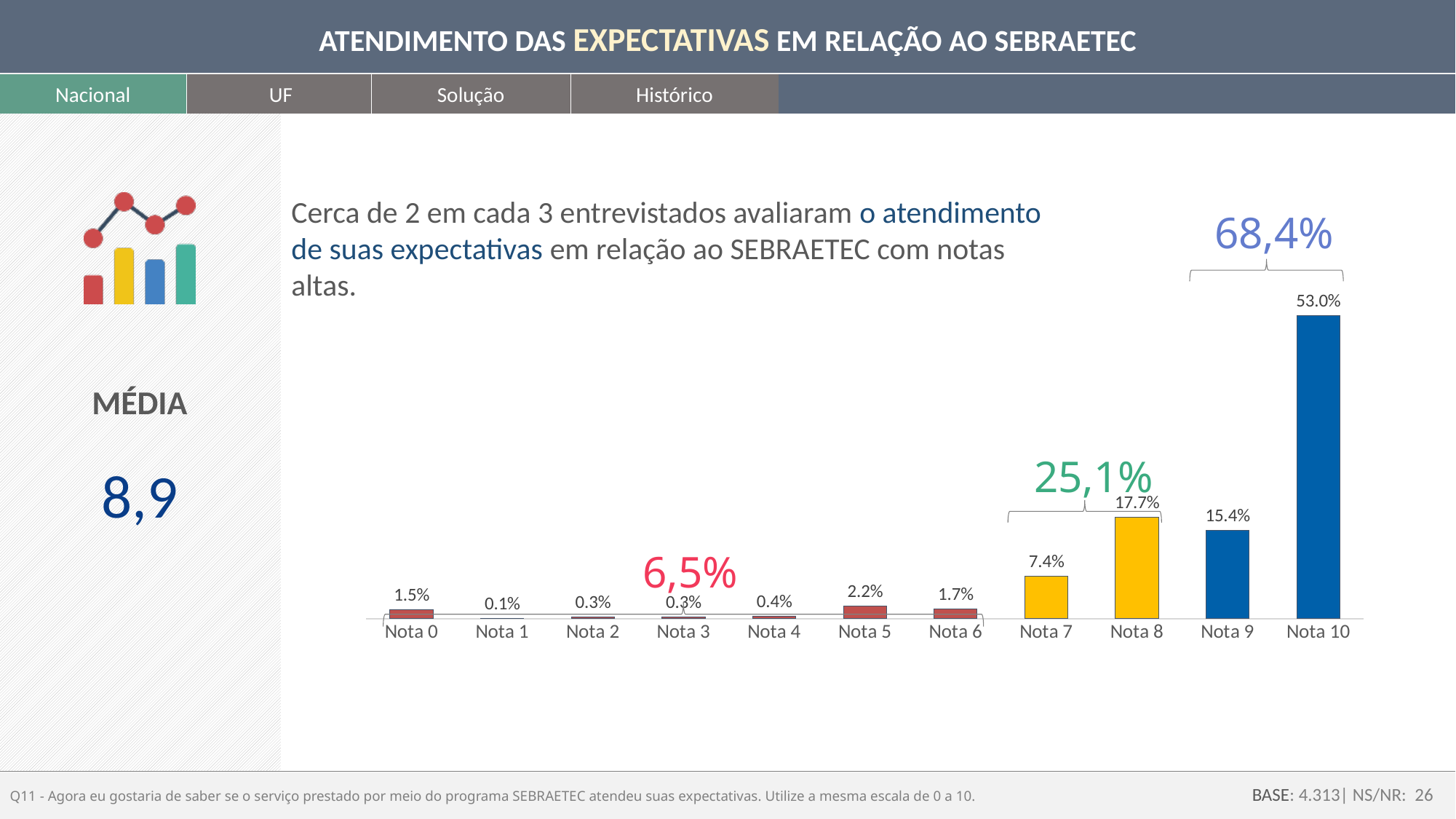
What is the difference between the values for Nota 10 and Nota 9? 37.6% What is the value for Nota 5? 2.2% What is the value for Nota 10? 53.0% What is the combined share shown above the bracket for Nota 9 and Nota 10? 68,4% Which category has the lowest value? Nota 1 Which is larger, the value for Nota 7 or the value for Nota 9? Nota 9 How many categories are shown on the x axis? 11 Which category has the highest value? Nota 10 What kind of chart is shown on the slide? Bar chart What is the value for Nota 8? 17.7% What is the combined share shown above the bracket for Nota 7 and Nota 8? 25,1% What is the value for Nota 0? 1.5%